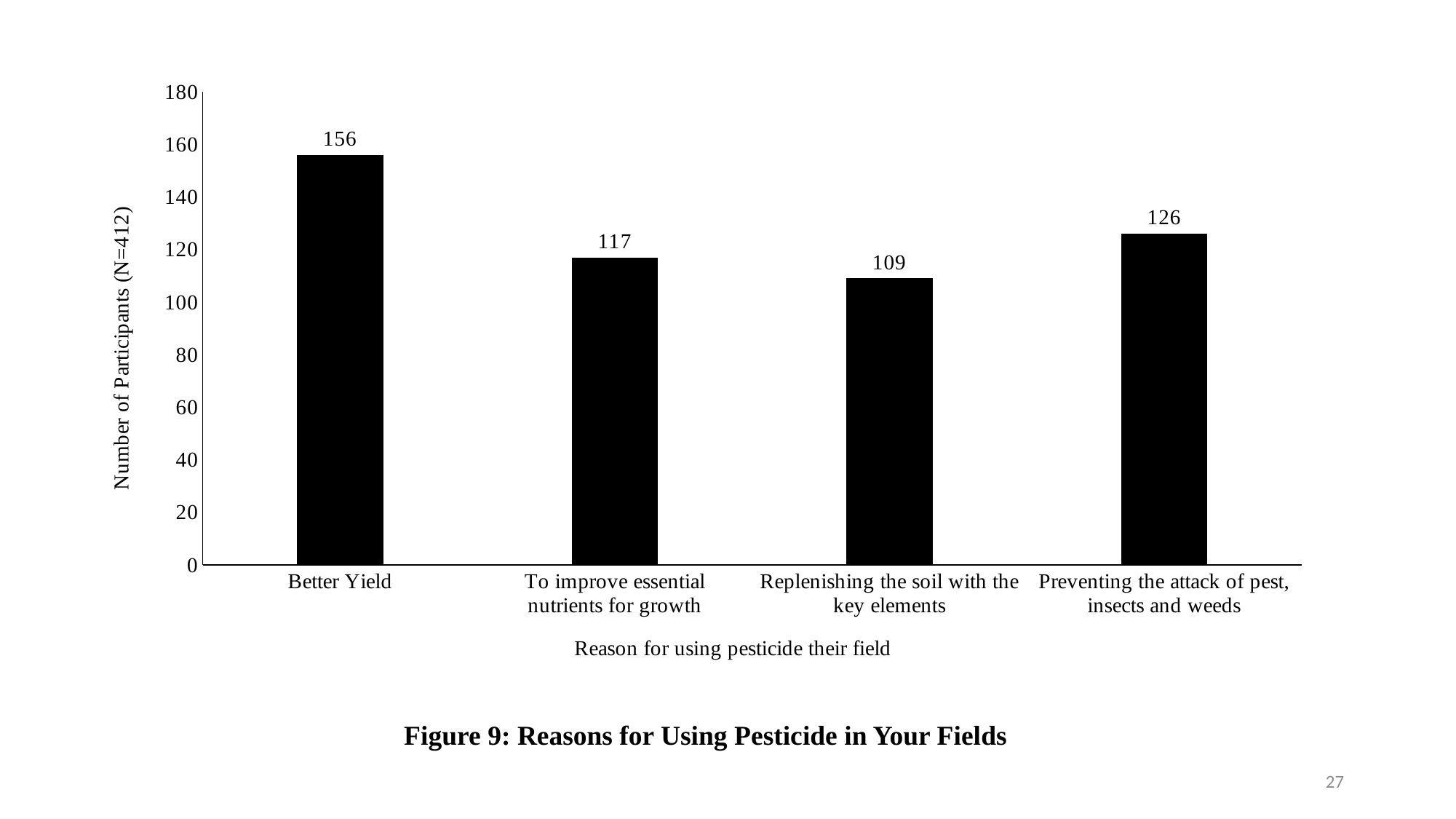
Which reason for using pesticide has the lowest number of participants? Replenishing the soil with the key elements What is the number of participants for "To improve essential nutrients for growth"? 117 What is the difference in participants between "Preventing the attack of pest, insects and weeds" and "To improve essential nutrients for growth"? 9 Which has more participants: "To improve essential nutrients for growth" or "Preventing the attack of pest, insects and weeds"? Preventing the attack of pest, insects and weeds Which reason for using pesticide has the highest number of participants? Better Yield What is the difference in participants between "Better Yield" and "Replenishing the soil with the key elements"? 47 What kind of chart is shown on the slide? Bar chart How many reasons for using pesticide are shown on the chart? 4 What is the title of the figure on the slide? Figure 9: Reasons for Using Pesticide in Your Fields How many participants gave "Better Yield" as their reason for using pesticide? 156 What is the number of participants for "Preventing the attack of pest, insects and weeds"? 126 What is the number of participants for "Replenishing the soil with the key elements"? 109